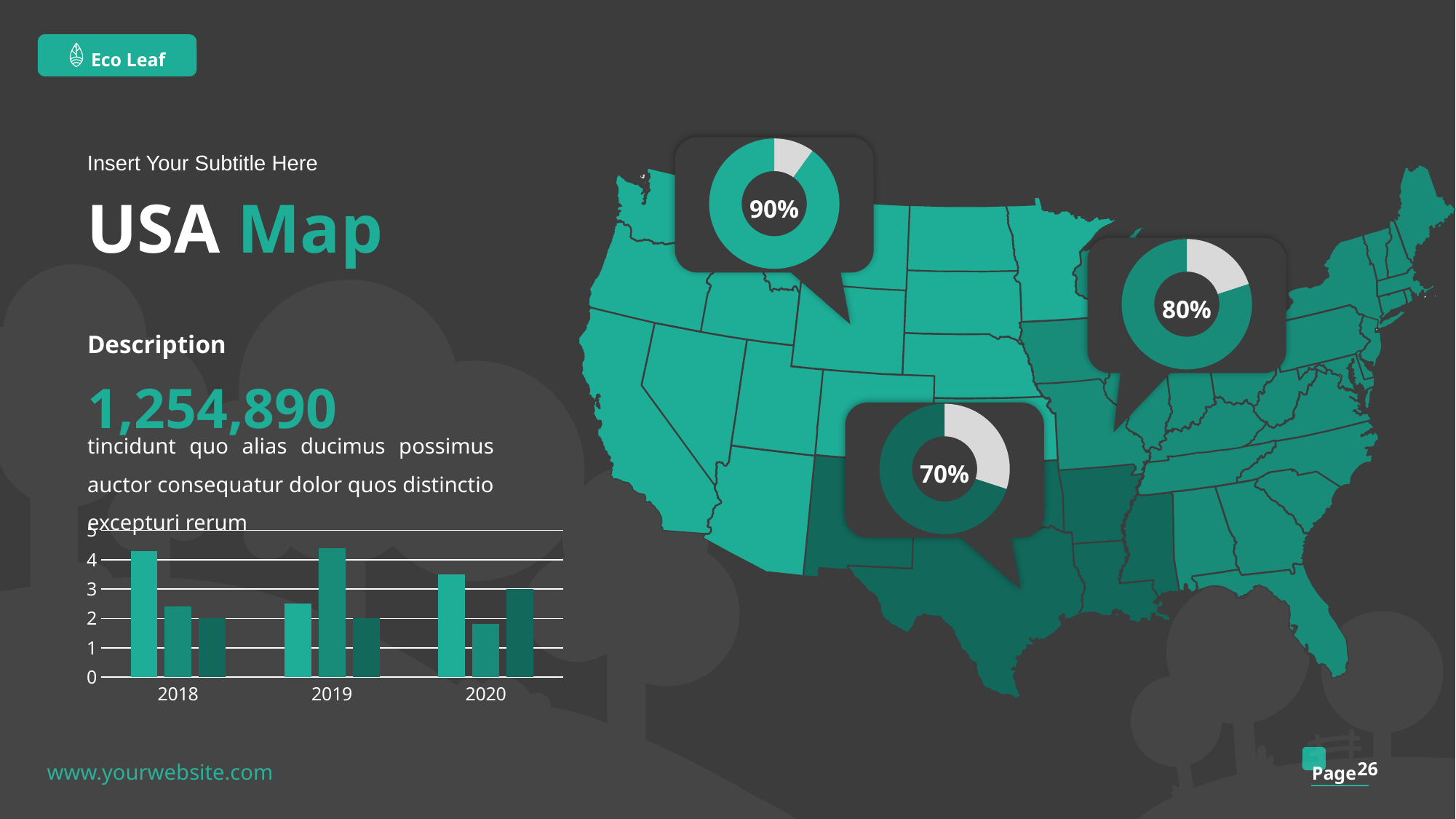
What kind of chart is shown at the bottom left of the slide, below the description text? bar chart In the bar chart at the bottom left, which bar is the tallest in the 2019 group? the middle bar In the bar chart at the bottom left, is the value of the middle bar for 2020 greater or less than 3? less In the bar chart at the bottom left, how many year categories are shown on the x axis? 3 In the bar chart at the bottom left, how many bars are there in each year group? 3 In the bar chart at the bottom left, is the value of the first (leftmost) bar for 2018 greater or less than 4? greater In the bar chart at the bottom left, which is larger for 2018: the first (leftmost) bar or the third (rightmost) bar? the first (leftmost) bar In the bar chart at the bottom left, is the value of the middle bar for 2019 greater or less than 4? greater What percentage is shown in the donut chart at the top left of the USA map? 90% Of the three donut charts on the USA map, which shows the lowest percentage? 70% What percentage is shown in the donut chart on the right side of the USA map? 80%